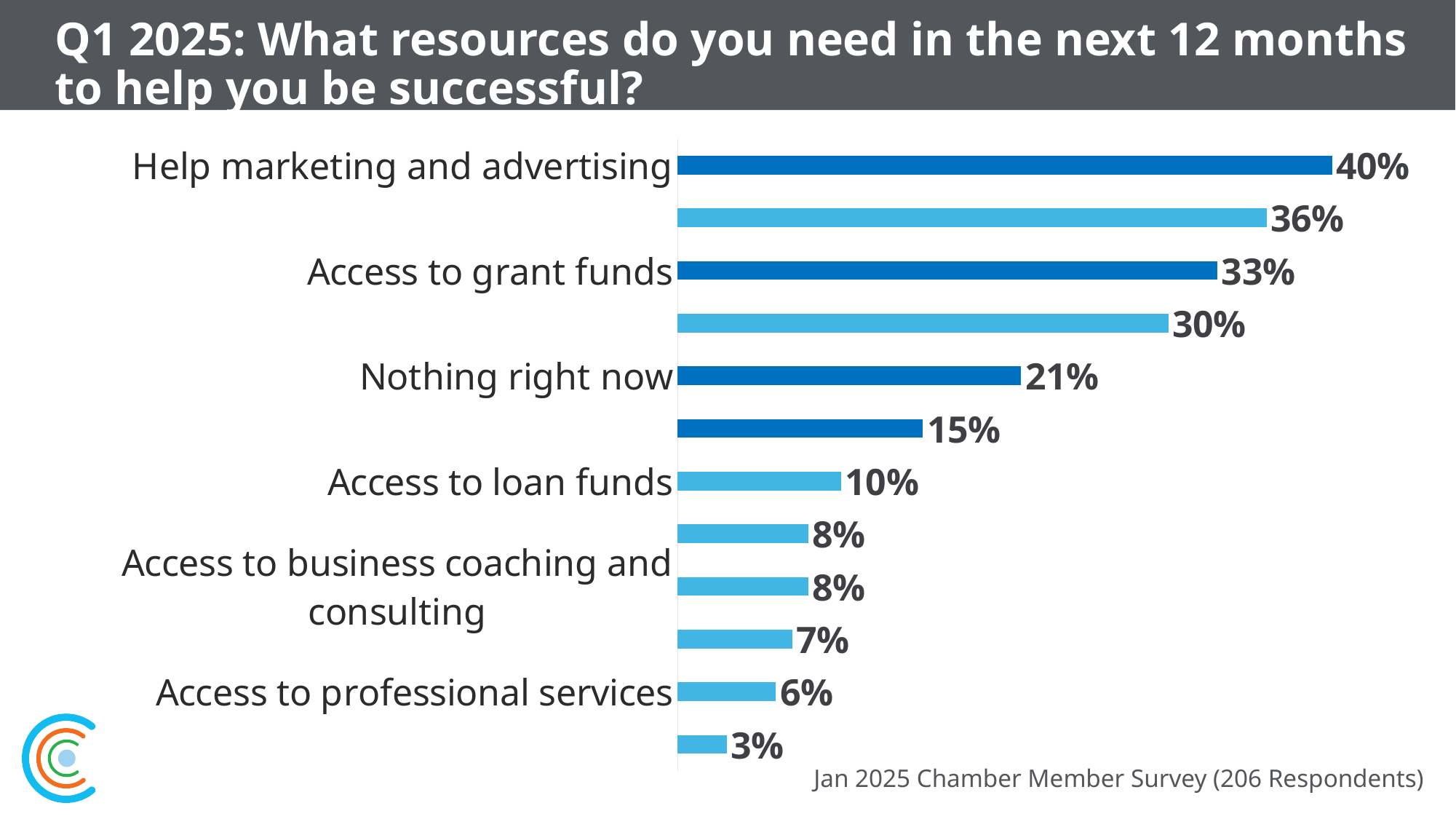
How many bars are plotted on the chart? 12 What percentage of respondents chose Nothing right now? 21% Which labeled resource has the highest percentage? Help marketing and advertising What is the value for Access to professional services? 6% What is the smallest value printed on the chart? 3% What kind of chart is shown on the slide? Bar chart What is the value for Access to loan funds? 10% What is the difference between Nothing right now and Access to loan funds? 11% What is the difference between Help marketing and advertising and Access to grant funds? 7% What percentage of respondents said they need help marketing and advertising? 40% What is the value shown for Access to grant funds? 33% Which is larger, Access to grant funds or Nothing right now? Access to grant funds